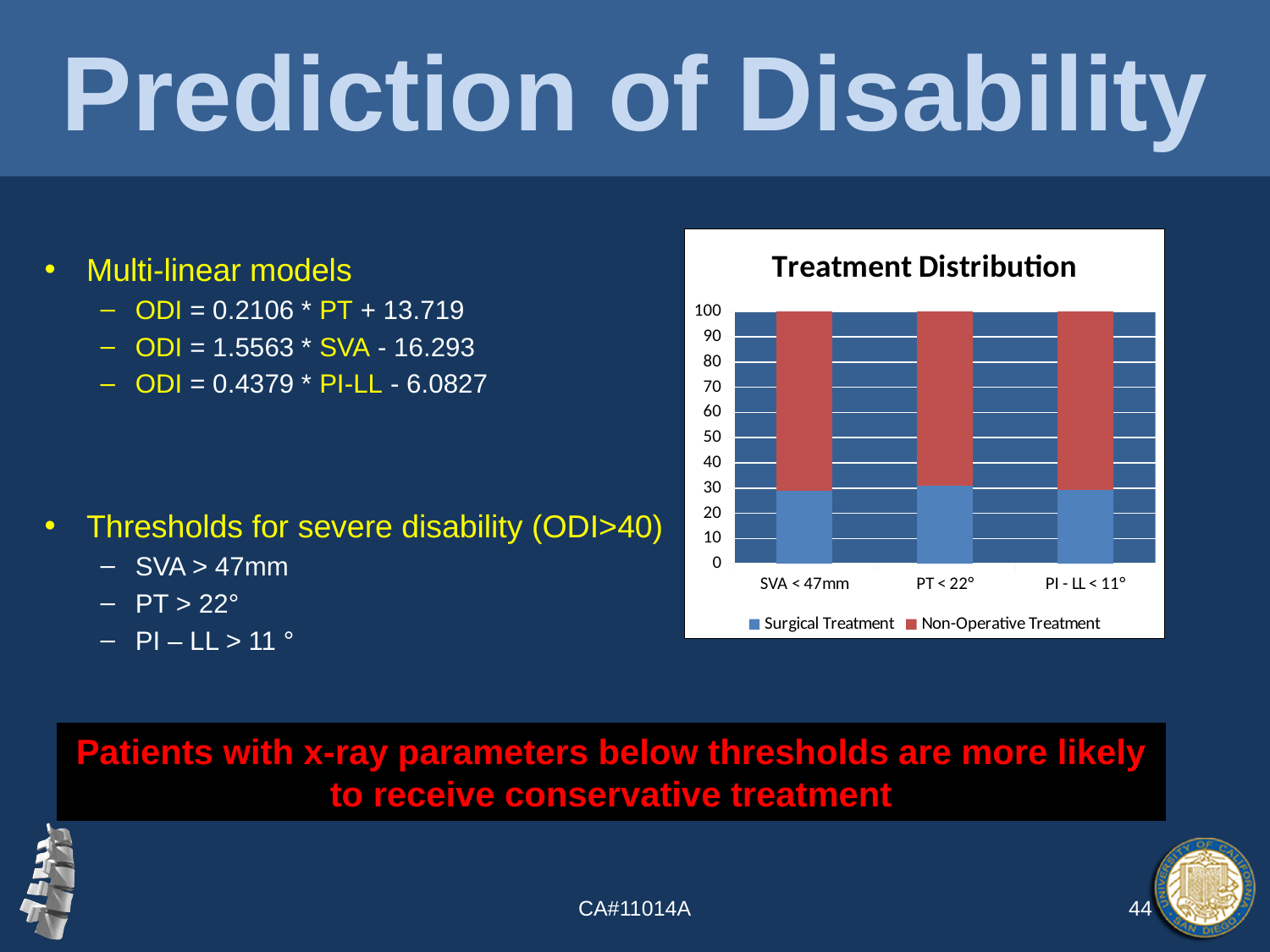
For the SVA < 47mm category, which is larger: the Surgical Treatment portion or the Non-Operative Treatment portion? Non-Operative Treatment Which series is shown in blue in the Treatment Distribution chart? Surgical Treatment How many series does the legend of the Treatment Distribution chart list? 2 What is the total height of the stacked bar for SVA < 47mm? 100 Is the Surgical Treatment value for PT < 22° greater or less than 20? greater What is the total height of the stacked bar for PI - LL < 11°? 100 Is the Surgical Treatment value for SVA < 47mm greater or less than 40? less What kind of chart is shown on the slide? Stacked bar chart What is the title of the chart? Treatment Distribution For the PT < 22° category, which is larger: the Surgical Treatment portion or the Non-Operative Treatment portion? Non-Operative Treatment Is the Surgical Treatment value for PI - LL < 11° greater or less than 50? less How many categories are shown on the x axis of the Treatment Distribution chart? 3